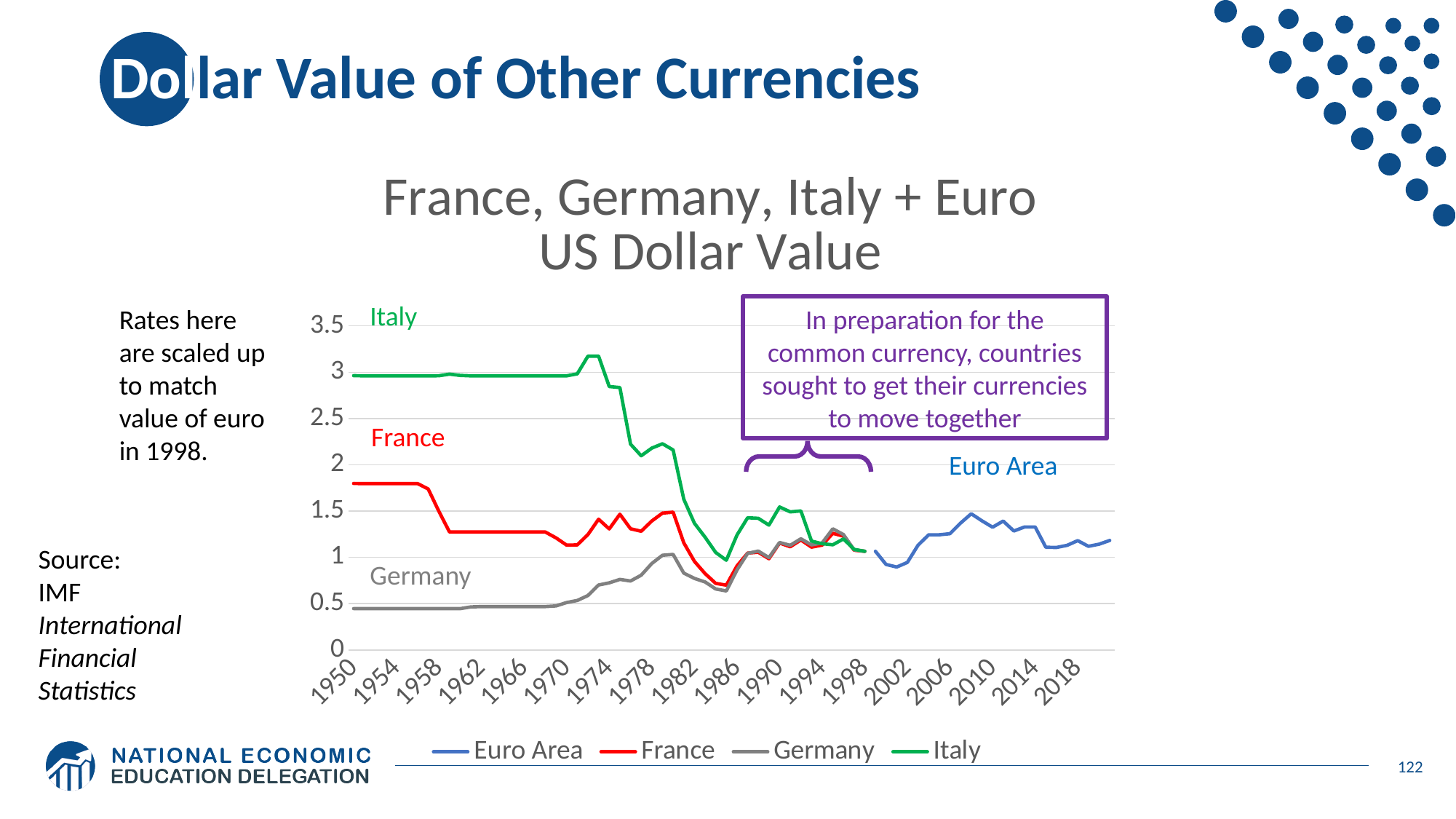
What is the title of the chart? France, Germany, Italy + Euro US Dollar Value In 1966, which is larger, the value for France or the value for Germany? France Is the value for Germany in 1950 greater or less than 1? less What kind of chart is shown on the slide? line chart Does the Germany line rise or fall overall between 1950 and 1980? rise Which series has the lowest value in 1950? Germany Which series has the highest value in 1950? Italy Is the value for France in 1950 greater or less than 1.5? greater What are the series listed in the chart's legend? Euro Area, France, Germany, Italy How many series does the chart's legend list? 4 Does the Italy line rise or fall overall between 1950 and 1986? fall Is the value for Italy in 1950 greater or less than 2.5? greater